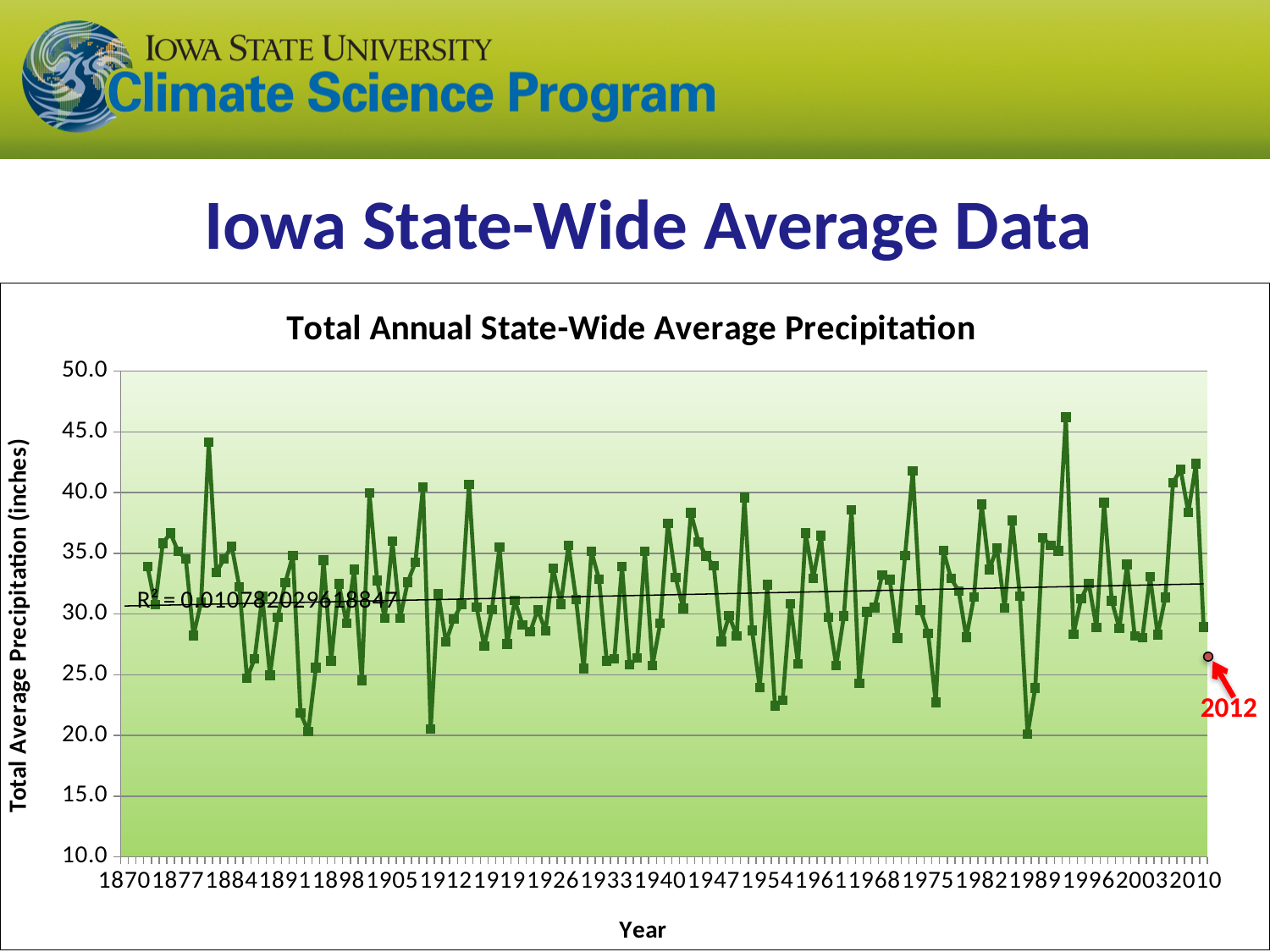
What kind of chart is shown on the slide? line chart Is the value for 2012 greater or less than 30? less How many data series are plotted on the chart? 1 Is the value for 2012 greater or less than 25? greater Does the straight trend line drawn through the data slope upward or downward from left to right? upward Is the lowest value plotted on the chart greater or less than 25? less What is the title of the chart? Total Annual State-Wide Average Precipitation